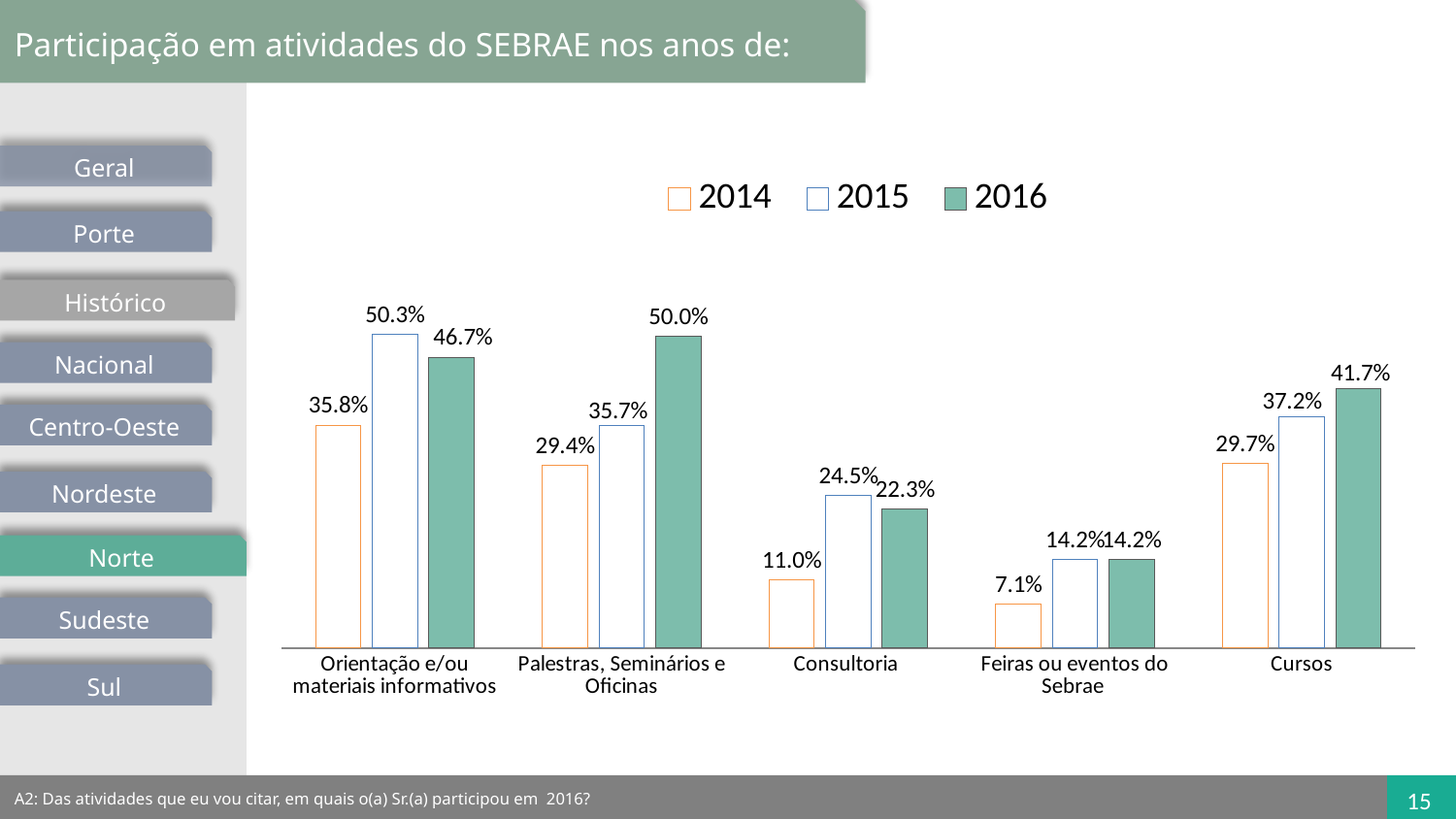
How many series does the legend list? 3 Do the values for Cursos rise or fall from 2014 to 2016? rise How many activity categories are shown on the x axis? 5 What is the difference between the 2016 and 2014 values for Palestras, Seminários e Oficinas? 20.6% What is the 2016 value for Cursos? 41.7% Which category has the highest 2016 value? Palestras, Seminários e Oficinas Which category has the lowest 2014 value? Feiras ou eventos do Sebrae For Consultoria, which is larger: the 2015 value or the 2016 value? 2015 Which year's series is shown with filled green bars? 2016 What is the 2014 value for Consultoria? 11.0% What kind of chart is shown on the slide? bar chart What is the 2015 value for Orientação e/ou materiais informativos? 50.3%